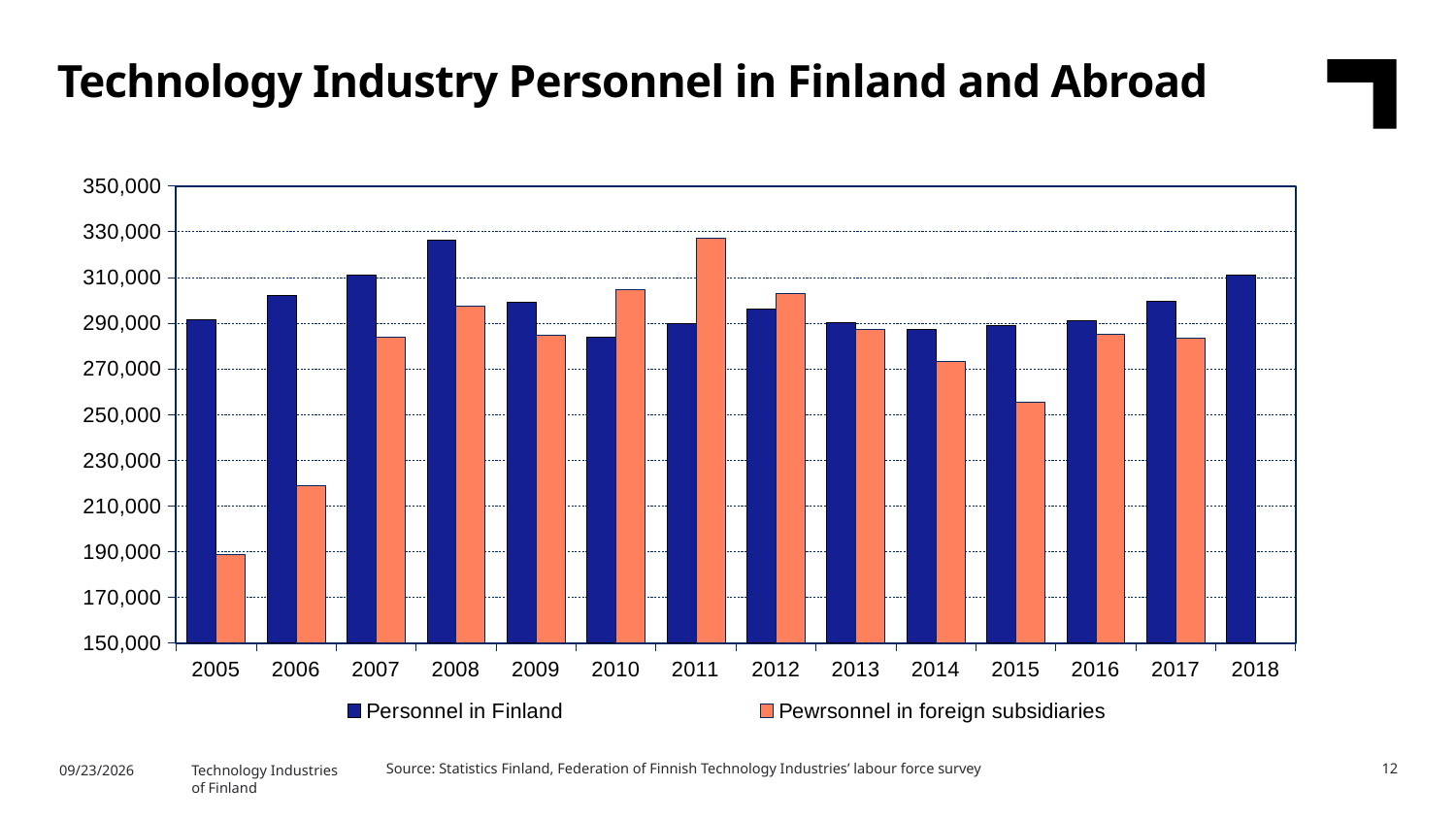
In 2005, which is larger: Personnel in Finland or Personnel in foreign subsidiaries? Personnel in Finland Is the value for Personnel in Finland in 2008 greater or less than 310,000? greater Is the value for Personnel in foreign subsidiaries in 2014 greater or less than 290,000? less In 2011, which is larger: Personnel in Finland or Personnel in foreign subsidiaries? Personnel in foreign subsidiaries In which year is Personnel in foreign subsidiaries highest? 2011 Does Personnel in foreign subsidiaries rise or fall from 2005 to 2008? rise What kind of chart is shown on the slide? Bar chart In which year is Personnel in foreign subsidiaries lowest? 2005 In which year is Personnel in Finland highest? 2008 Is the value for Personnel in foreign subsidiaries in 2006 greater or less than 230,000? less How many series does the legend list? 2 How many years are shown on the x axis? 14